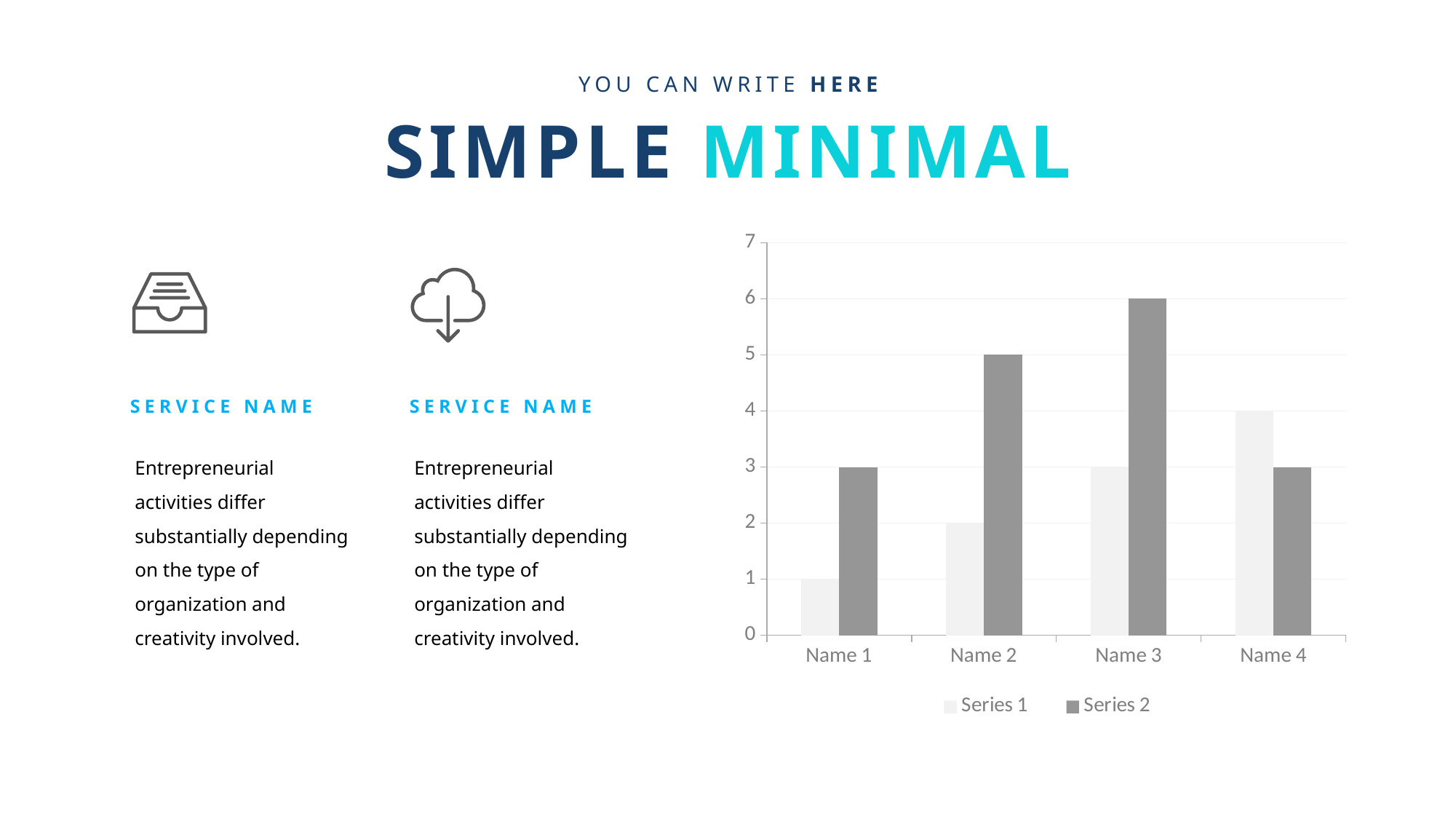
For Name 4, which is larger, Series 1 or Series 2? Series 1 What is the value of Series 2 for Name 3? 6 How many categories are shown on the x axis of the chart? 4 What type of chart is shown on the slide? bar chart What is the difference between the Series 2 and Series 1 values for Name 2? 3 What are the two entries listed in the chart's legend? Series 1 and Series 2 What is the value of Series 1 for Name 1? 1 Which category has the lowest Series 1 value? Name 1 How many series does the chart's legend list? 2 What is the value of Series 2 for Name 2? 5 Which category has the highest Series 2 value? Name 3 Do the Series 1 values rise or fall from Name 1 to Name 4? rise